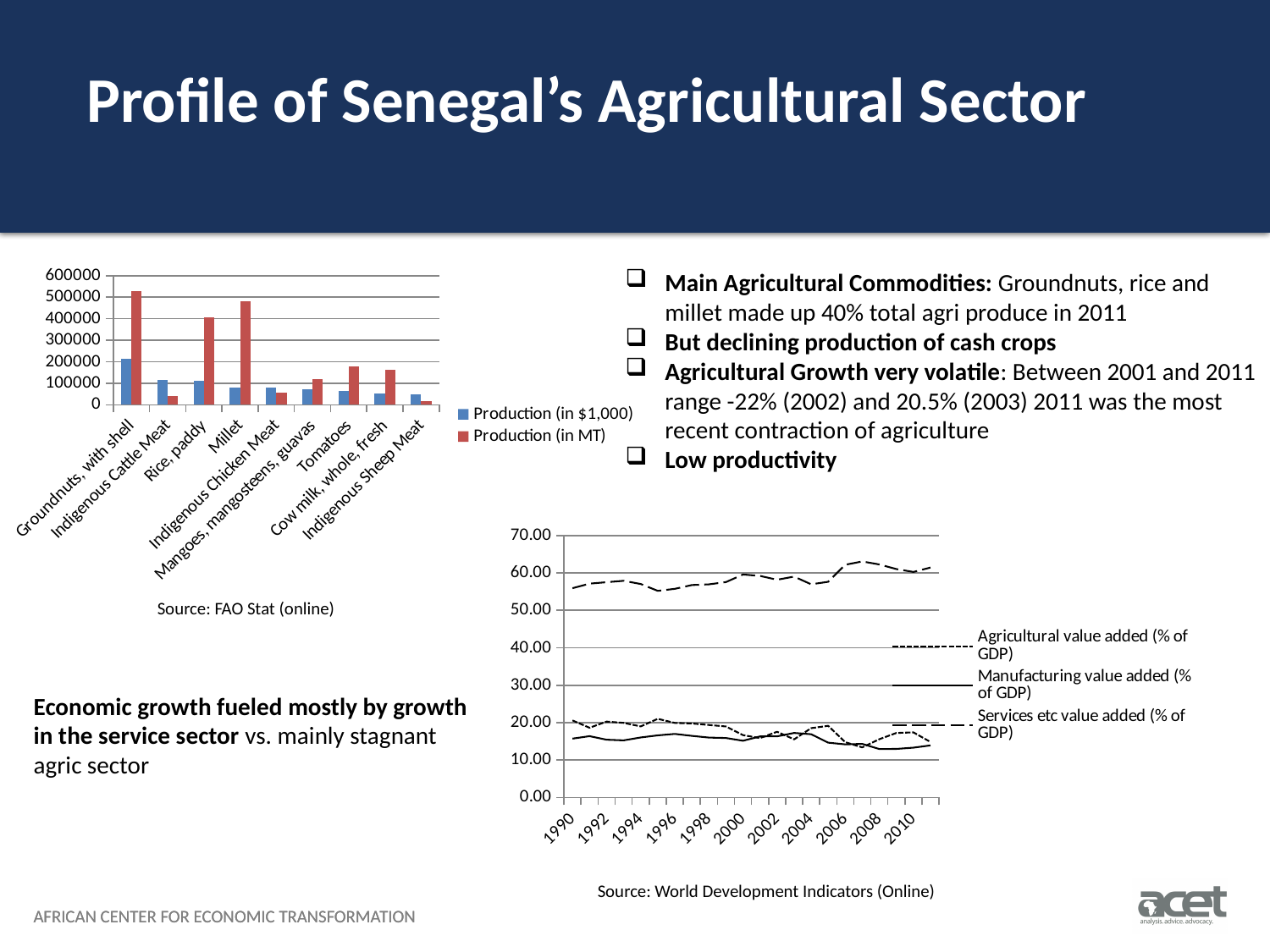
What kind of chart is the chart on the lower right of the slide (sourced from World Development Indicators)? line chart In the bar chart on the left, is the Production (in MT) for Millet greater or less than 500000? less In the line chart on the lower right, is the value for Services etc value added (% of GDP) in 2007 greater or less than 60.00? greater In the bar chart on the left, which has the larger Production (in MT): Millet or Rice, paddy? Millet In the bar chart on the left, how many series does the legend list? 2 In the line chart on the lower right, how many series does the legend list? 3 In the bar chart on the left, is the Production (in MT) for Indigenous Cattle Meat greater or less than 100000? less In the bar chart on the left, which commodity has the highest Production (in MT)? Groundnuts, with shell In the bar chart on the left, how many commodity categories are shown on the x axis? 9 In the line chart on the lower right, does Agricultural value added (% of GDP) rise or fall overall from 1990 to 2010? fall What kind of chart is the chart on the left of the slide (sourced from FAO Stat)? bar chart